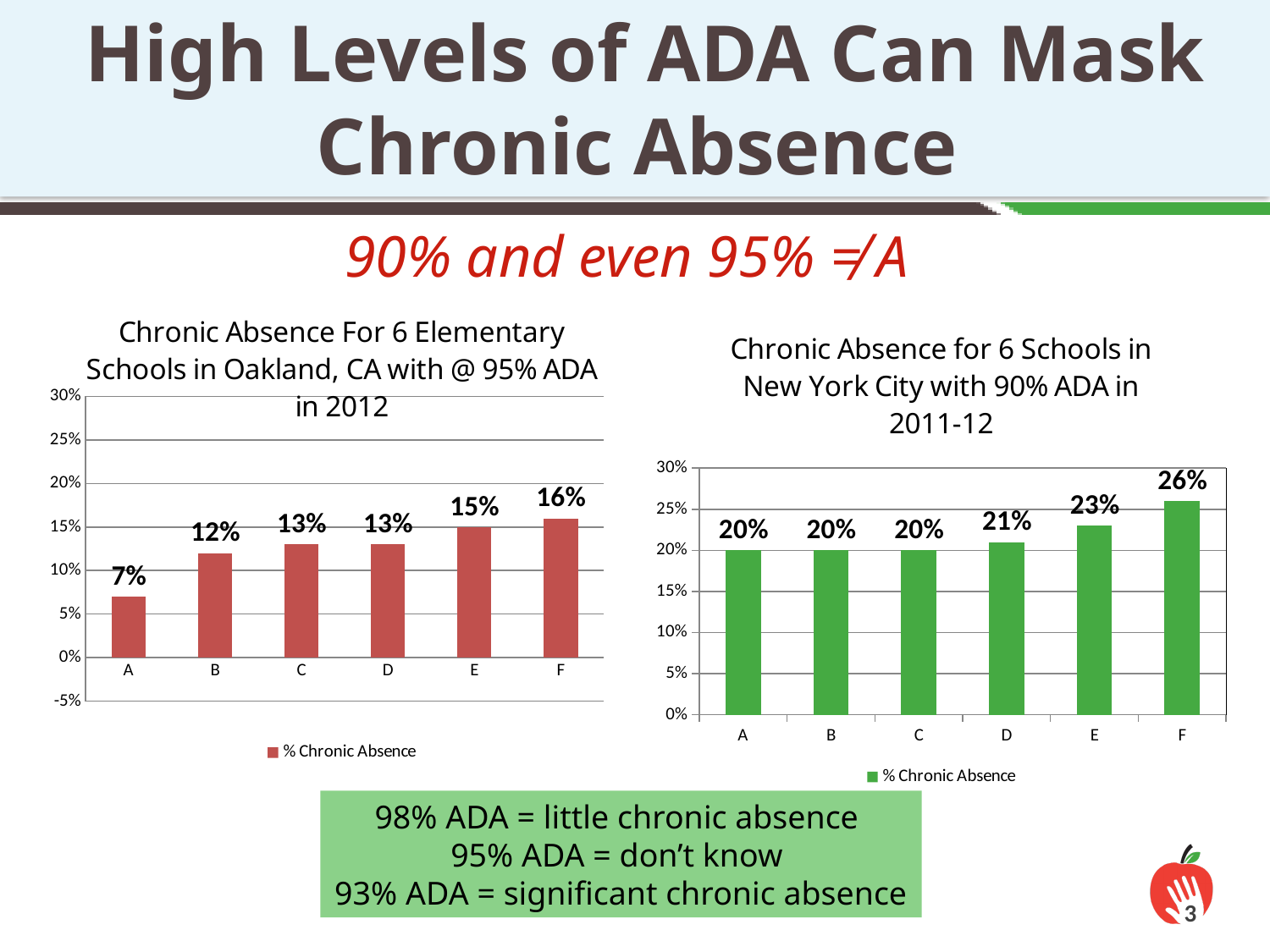
In the New York City chart on the right, do the values rise or fall from school A to school F? Rise In the New York City chart on the right, what is the % Chronic Absence for school F? 26% How many series does the legend of the Oakland chart on the left list? 1 How many schools are shown in the Oakland chart on the left? 6 In the Oakland chart on the left, what is the difference between the % Chronic Absence for school F and school A? 9% In the New York City chart on the right, which school has the highest % Chronic Absence? F In the Oakland chart on the left, which school has the lowest % Chronic Absence? A In the New York City chart on the right, which school has a larger % Chronic Absence, D or E? E What type of chart is the New York City chart on the right? Bar chart In the New York City chart on the right, what is the difference between the % Chronic Absence for school F and school E? 3% In the Oakland chart on the left, what is the % Chronic Absence for school A? 7% In the Oakland chart on the left, which school has the highest % Chronic Absence? F